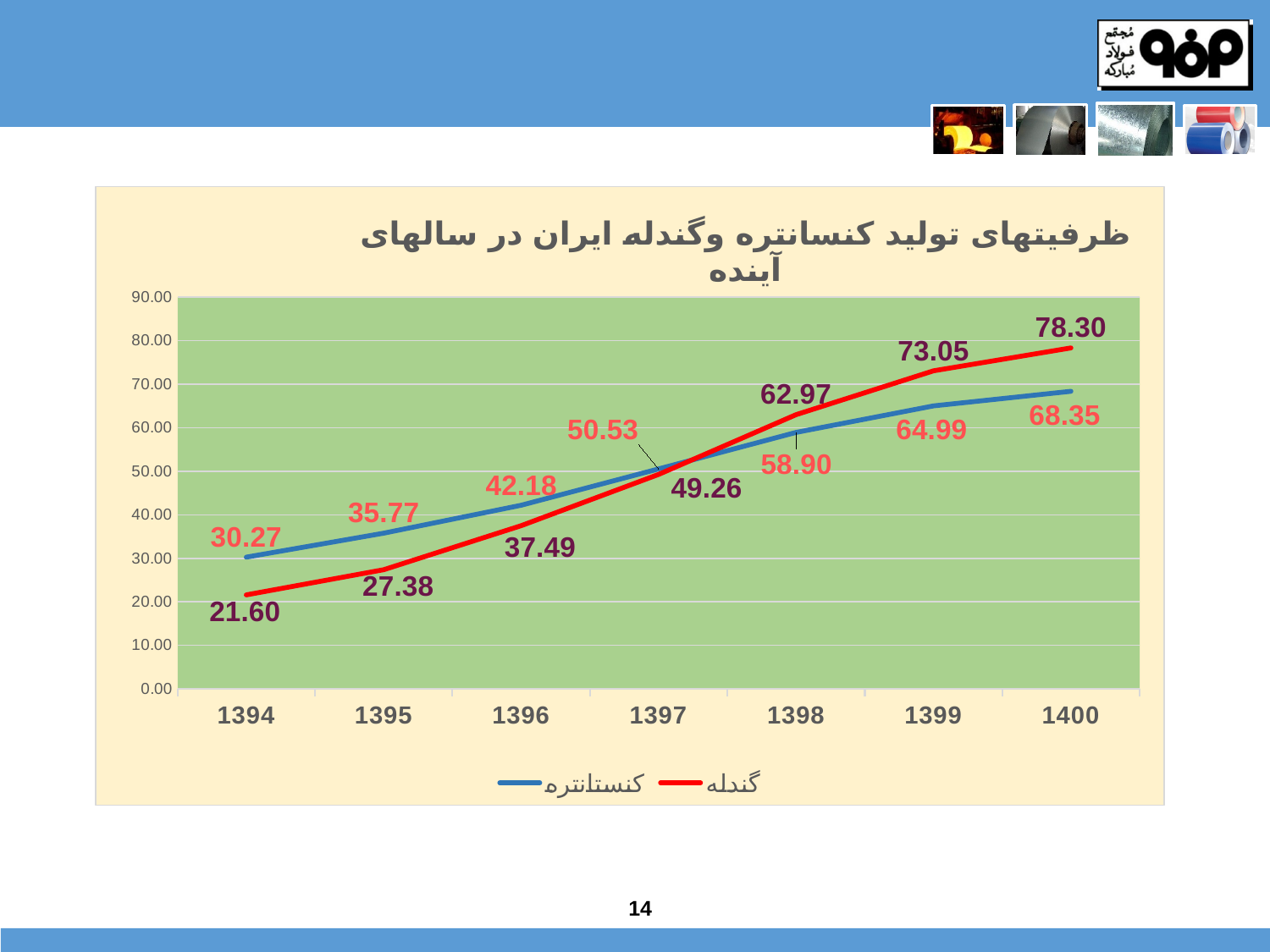
How many series does the legend list? 2 How many years are shown on the x axis? 7 What is the value for گندله in 1400? 78.30 What is the value for کنسانتره in 1394? 30.27 What is the value for کنسانتره in 1398? 58.90 Do the values for گندله rise or fall from 1394 to 1400? rise Which series has the larger value in 1395, کنسانتره or گندله? کنسانتره What is the value for گندله in 1397? 49.26 What is the difference between گندله and کنسانتره in 1400? 9.95 In which year is the value for گندله lowest? 1394 In which year is the value for کنسانتره highest? 1400 What type of chart is shown on the slide? line chart